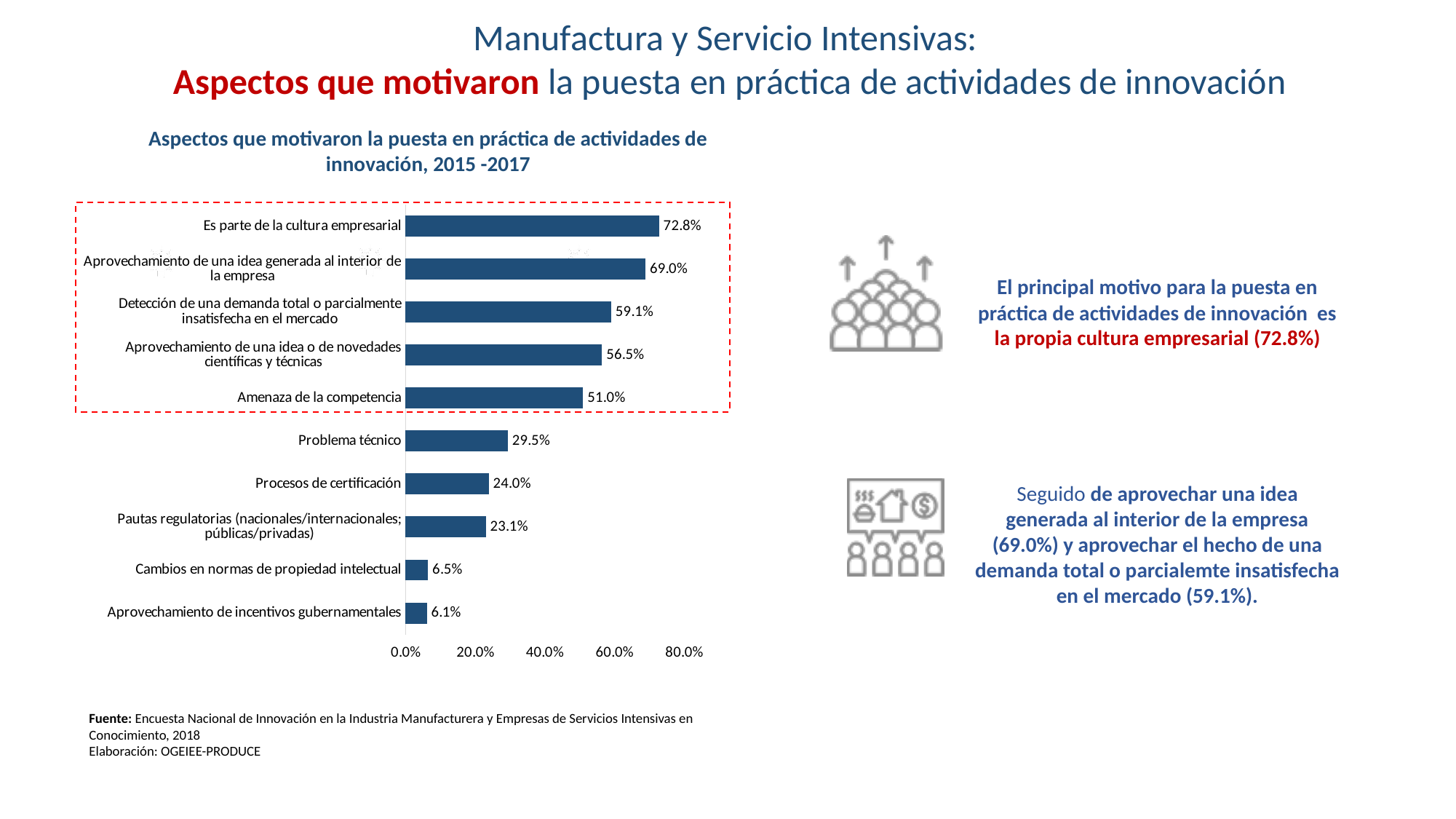
What is the value for 'Es parte de la cultura empresarial'? 72.8% Which category has the lowest value? Aprovechamiento de incentivos gubernamentales What is the difference between 'Es parte de la cultura empresarial' and 'Amenaza de la competencia'? 21.8% What is the title of the chart? Aspectos que motivaron la puesta en práctica de actividades de innovación, 2015 -2017 Is the value for 'Pautas regulatorias (nacionales/internacionales; públicas/privadas)' greater or less than 40.0%? less What is the value for 'Procesos de certificación'? 24.0% What kind of chart is shown on the slide? bar chart What is the difference between 'Cambios en normas de propiedad intelectual' and 'Aprovechamiento de incentivos gubernamentales'? 0.4% What is the value for 'Problema técnico'? 29.5% How many categories are shown in the chart? 10 Which category has the highest value? Es parte de la cultura empresarial Which is larger: 'Detección de una demanda total o parcialmente insatisfecha en el mercado' or 'Aprovechamiento de una idea o de novedades científicas y técnicas'? Detección de una demanda total o parcialmente insatisfecha en el mercado